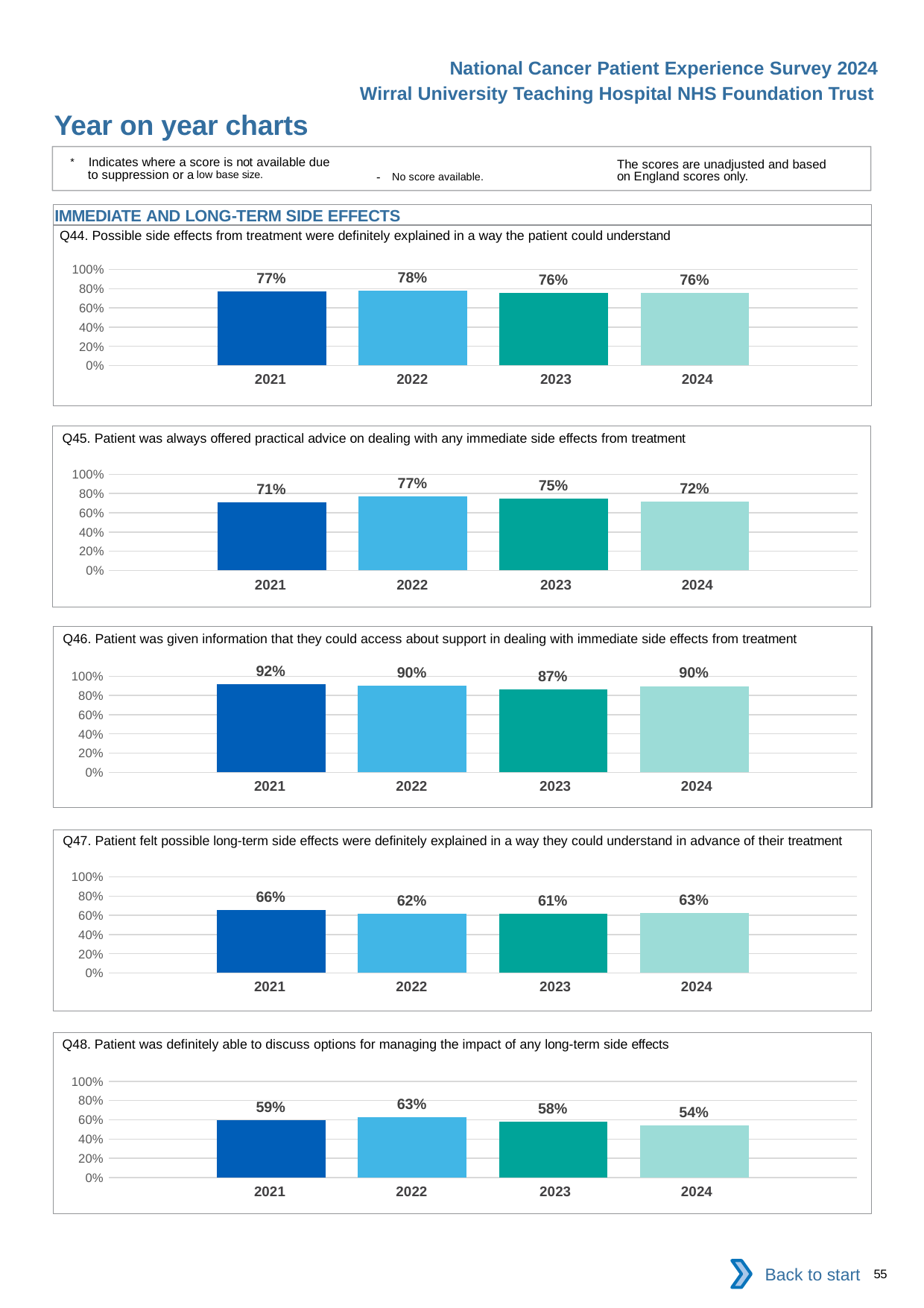
In the Q45 chart, which year has the lowest value? 2021 In the Q48 chart, what is the difference between the 2022 and 2024 values? 9% In the Q47 chart, what is the value for 2023? 61% In the Q45 chart, what is the difference between the 2022 and 2021 values? 6% How many years are shown in the Q44 chart? 4 In the Q44 chart, what is the value for 2022? 78% In the Q46 chart, what is the value for 2023? 87% In the Q48 chart, which year has the lowest value? 2024 What kind of chart is the Q48 chart? Bar chart In the Q47 chart, which is larger, the value for 2021 or the value for 2024? 2021 How many charts are shown on the slide? 5 In the Q46 chart, which year has the highest value? 2021